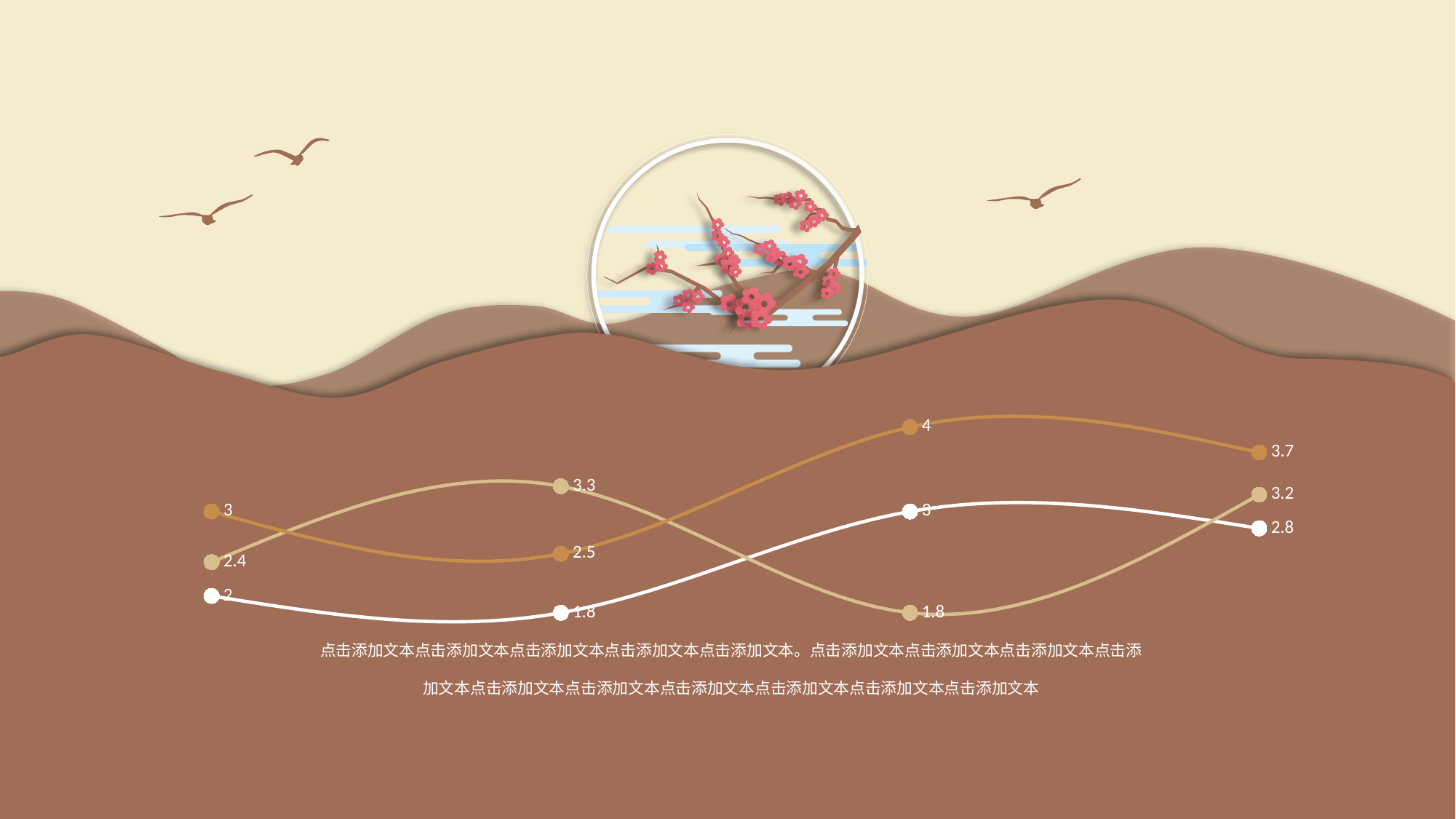
What is the highest value labelled anywhere on the chart? 4 What is the difference between the third point (4) and the second point (2.5) on the orange line? 1.5 Does the white line rise or fall between its third point (3) and its fourth point (2.8)? fall What is the value of the last point on the tan (light beige) line? 3.2 By how much does the white line rise from its first point (2) to its last point (2.8)? 0.8 What is the value of the third point on the orange line? 4 At the last point, which line has the larger value, the orange line (3.7) or the white line (2.8)? the orange line How many lines are plotted on the chart? 3 How many data points does each line on the chart have? 4 What kind of chart is shown on the slide? line chart What is the lowest value on the tan (light beige) line? 1.8 What is the value of the second point on the white line? 1.8